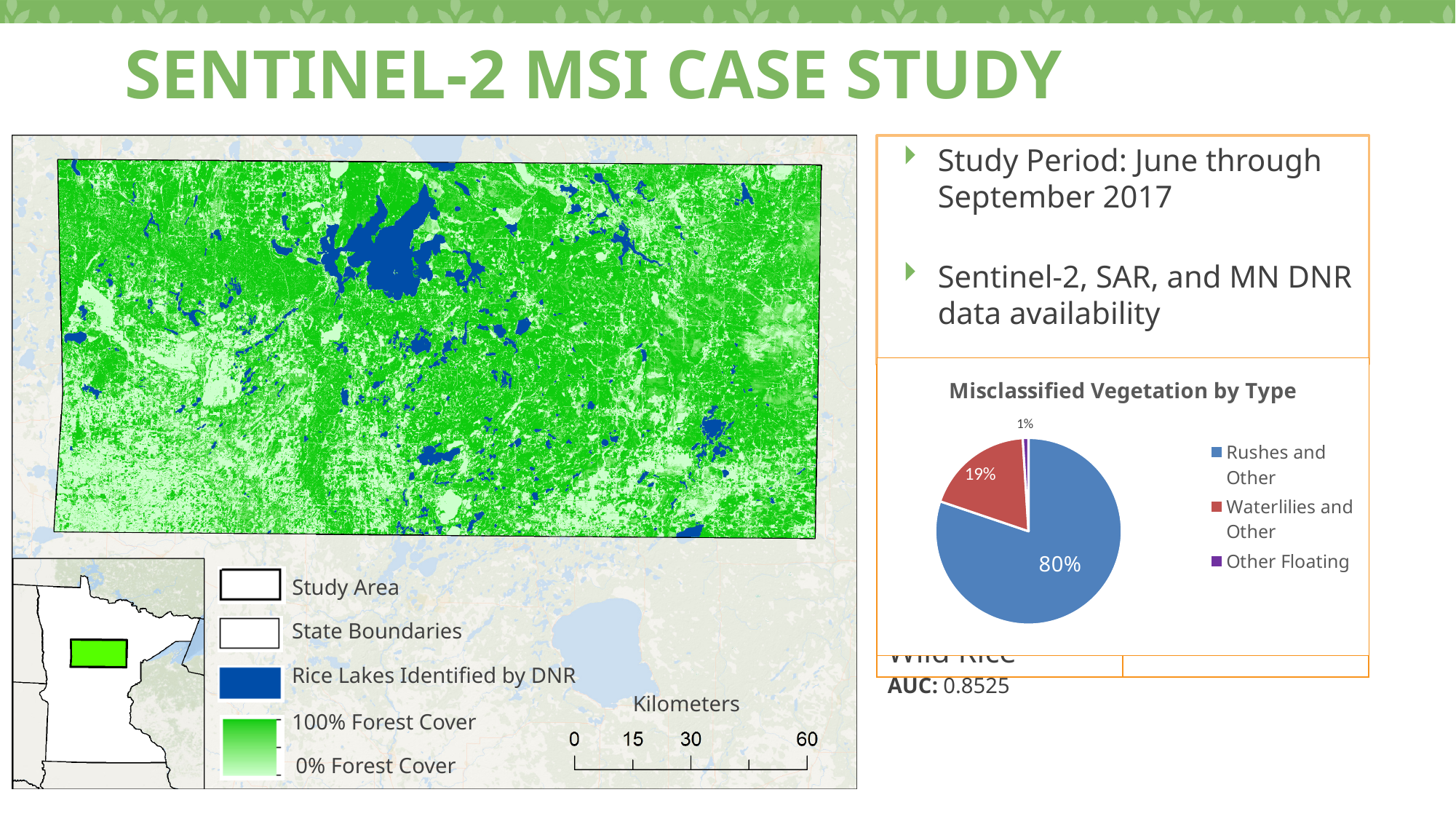
What kind of chart is 'Misclassified Vegetation by Type'? pie chart Which is larger in the pie chart, 'Waterlilies and Other' or 'Other Floating'? Waterlilies and Other What is the difference in percentage points between 'Rushes and Other' and 'Waterlilies and Other'? 61 Which category has the largest slice in the pie chart? Rushes and Other What colour is the 'Waterlilies and Other' slice in the pie chart? red What share of the pie does 'Waterlilies and Other' take? 19% How many categories does the pie chart show? 3 What share of the pie does 'Other Floating' take? 1% Which category has the smallest slice in the pie chart? Other Floating What is the title of the pie chart on the slide? Misclassified Vegetation by Type What share of the pie does 'Rushes and Other' take? 80% How many entries does the pie chart legend list? 3